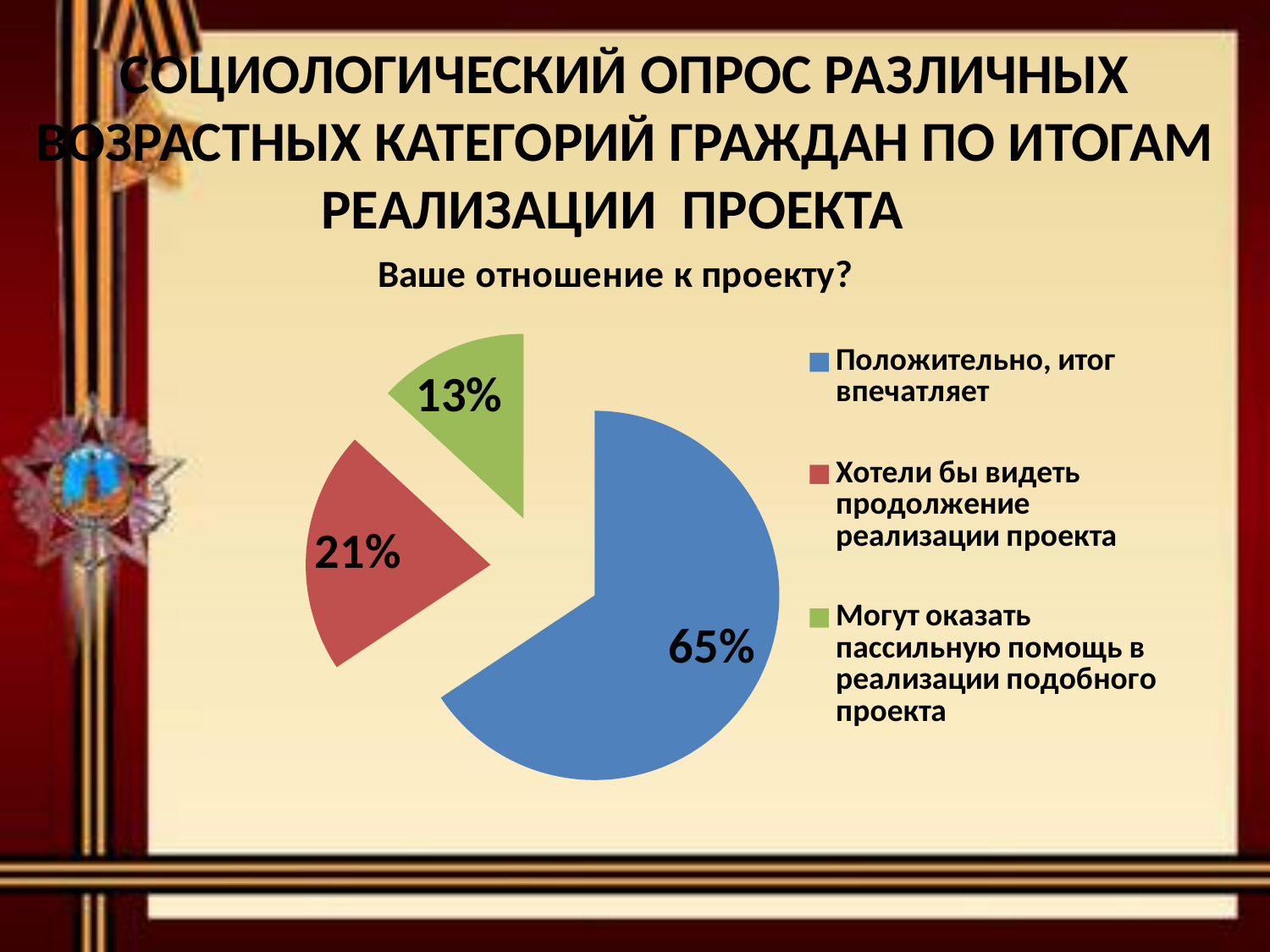
What kind of chart is shown on the slide? pie chart How many slices does the pie chart have? 3 What share of respondents answered "Хотели бы видеть продолжение реализации проекта"? 21% What colour is the slice for "Положительно, итог впечатляет"? blue What share of respondents answered "Могут оказать пассильную помощь в реализации подобного проекта"? 13% Which answer has the largest share of the pie? Положительно, итог впечатляет What is the chart's title? Ваше отношение к проекту? What share of respondents answered "Положительно, итог впечатляет"? 65% Which is larger: the share for "Хотели бы видеть продолжение реализации проекта" or the share for "Могут оказать пассильную помощь в реализации подобного проекта"? Хотели бы видеть продолжение реализации проекта How many entries does the legend list? 3 What is the difference in percentage points between the "Положительно, итог впечатляет" slice and the "Хотели бы видеть продолжение реализации проекта" slice? 44 Which answer has the smallest share of the pie? Могут оказать пассильную помощь в реализации подобного проекта